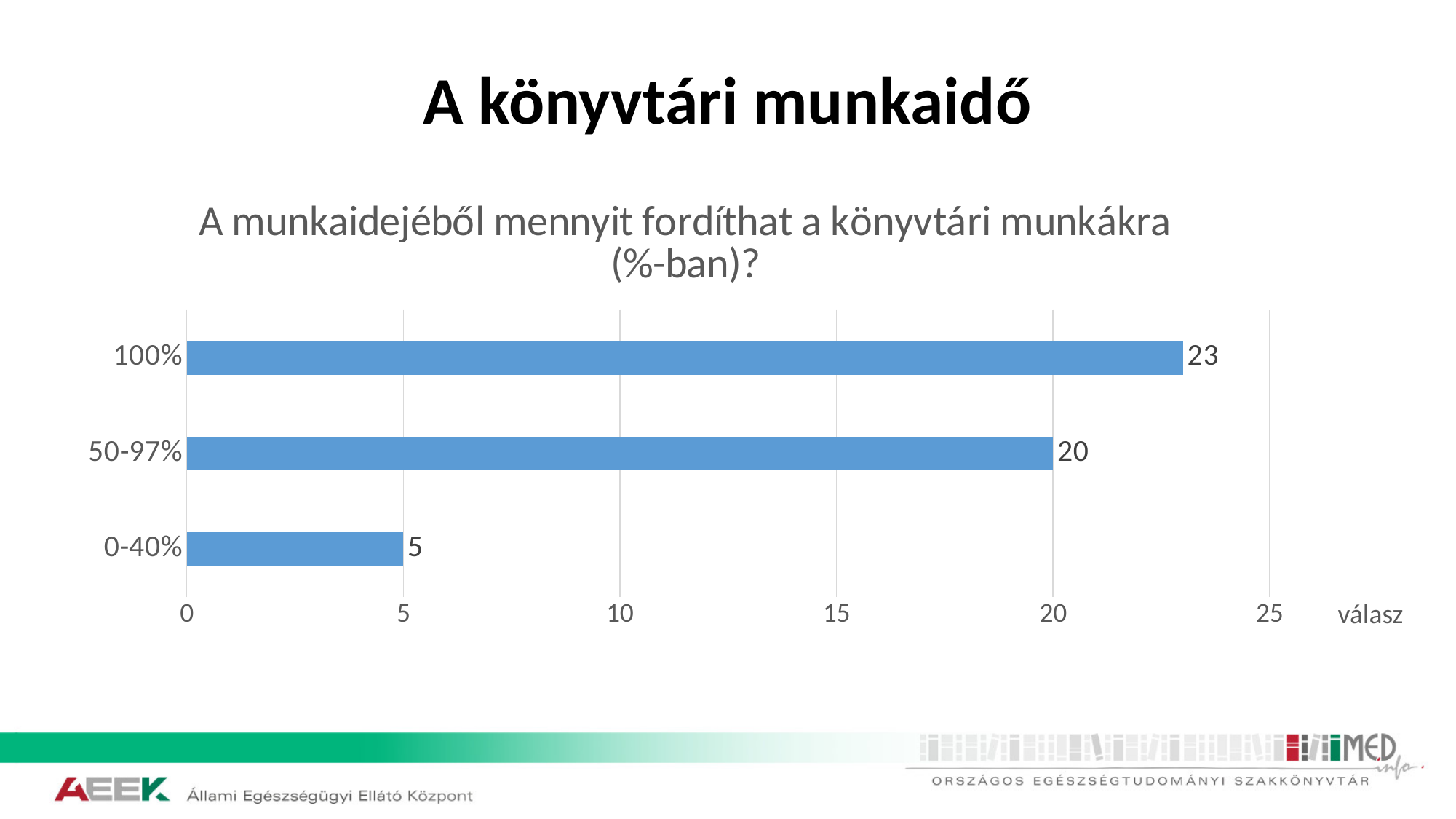
What is the value for the 0-40% category? 5 What is the difference between the values for 100% and 50-97%? 3 What is the value for the 50-97% category? 20 What is the difference between the values for 50-97% and 0-40%? 15 Is the value for 100% greater or less than 20? greater What kind of chart is shown on the slide? bar chart What is the value for the 100% category? 23 Which is larger, the value for 50-97% or the value for 0-40%? 50-97% What is the title of the chart? A munkaidejéből mennyit fordíthat a könyvtári munkákra (%-ban)? Which category has the lowest value? 0-40% Which category has the highest value? 100% How many categories are shown in the chart? 3